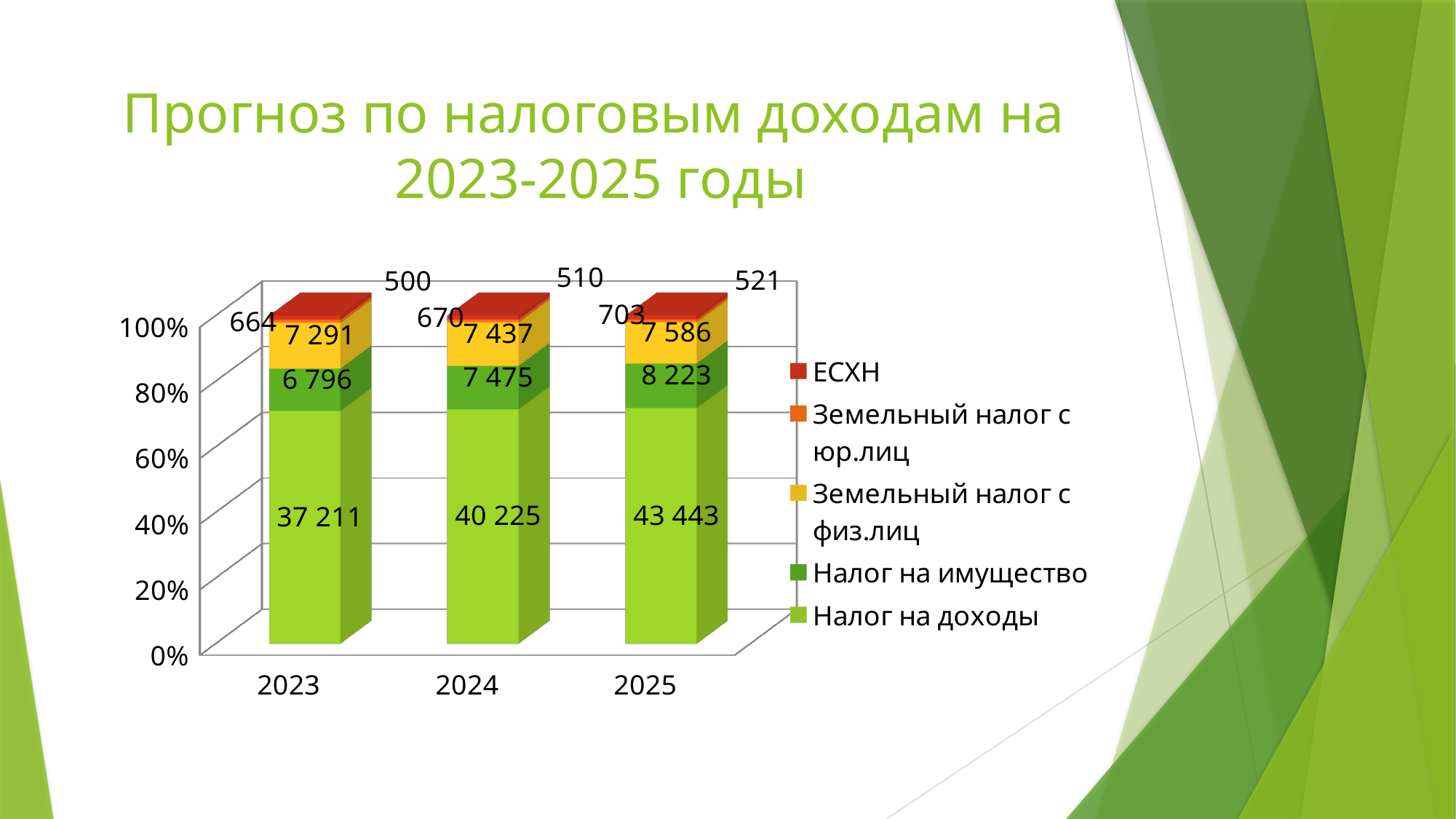
In which year is Налог на имущество lowest? 2023 Which is larger in 2024: Налог на имущество or Земельный налог с физ.лиц? Налог на имущество How many years (categories) are shown on the x axis? 3 What is the value of Налог на доходы for 2024? 40 225 In which year is Налог на доходы highest? 2025 What is the difference between Налог на доходы in 2025 and in 2023? 6 232 Does Налог на доходы rise or fall from 2023 to 2025? Rise What is the value of ЕСХН for 2025? 703 What type of chart is shown on the slide? Stacked bar chart What is the value of Земельный налог с физ.лиц for 2023? 7 291 What is the value of Налог на имущество for 2025? 8 223 How many series does the legend list? 5